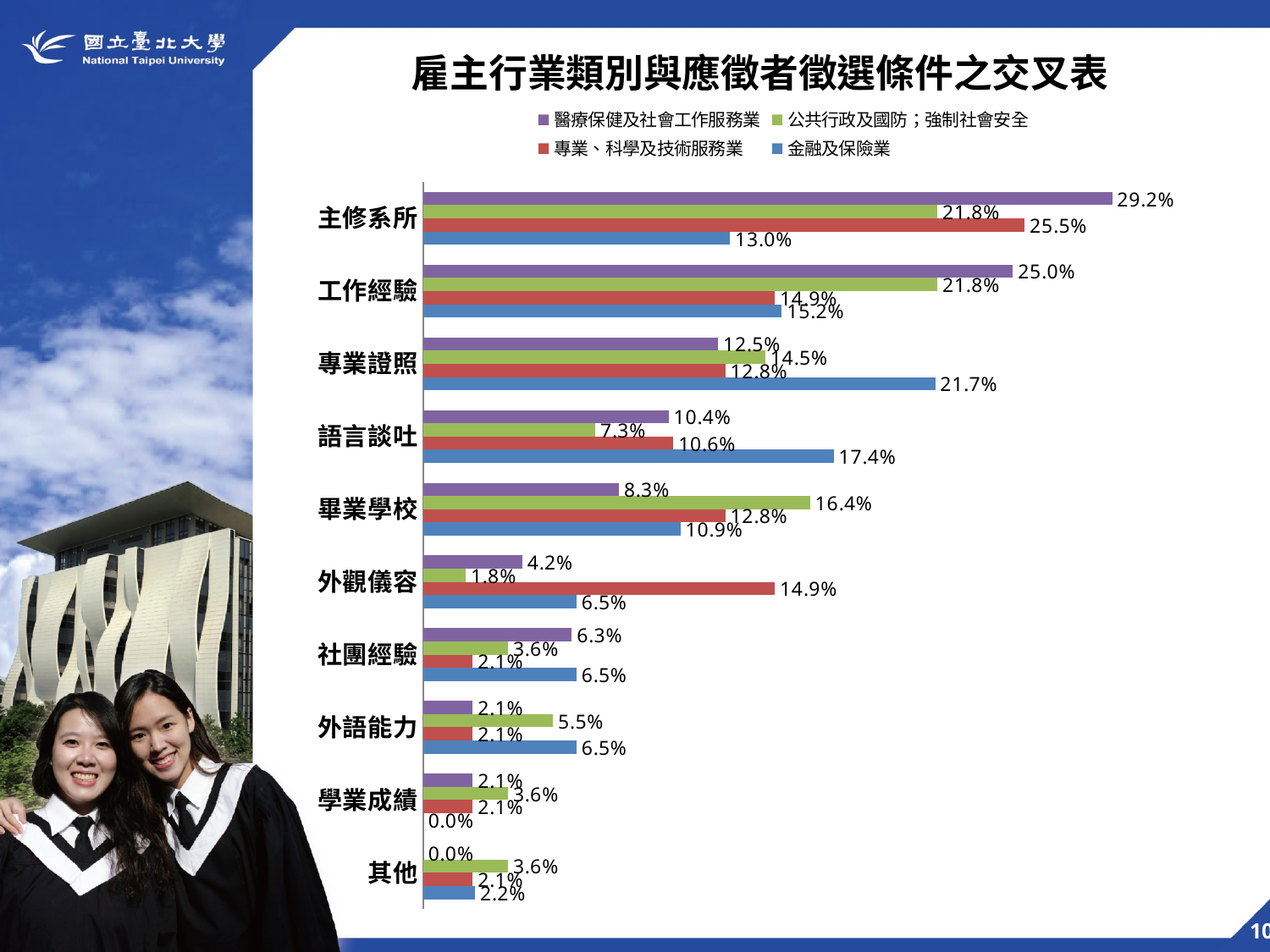
For 語言談吐, which series has the larger value: 金融及保險業 or 公共行政及國防；強制社會安全? 金融及保險業 What is the value for 畢業學校 in the 公共行政及國防；強制社會安全 series? 16.4% Which category has the lowest value in the 金融及保險業 series? 學業成績 How many series does the legend list? 4 What is the value for 外觀儀容 in the 專業、科學及技術服務業 series? 14.9% What is the value for 主修系所 in the 醫療保健及社會工作服務業 series? 29.2% What is the value for 專業證照 in the 金融及保險業 series? 21.7% What is the difference between the 醫療保健及社會工作服務業 and 金融及保險業 values for 主修系所? 16.2% Which category has the highest value in the 公共行政及國防；強制社會安全 series? 主修系所 and 工作經驗 (tied at 21.8%) How many categories are shown on the vertical axis? 10 What type of chart is shown on the slide? bar chart What is the title of the chart? 雇主行業類別與應徵者徵選條件之交叉表